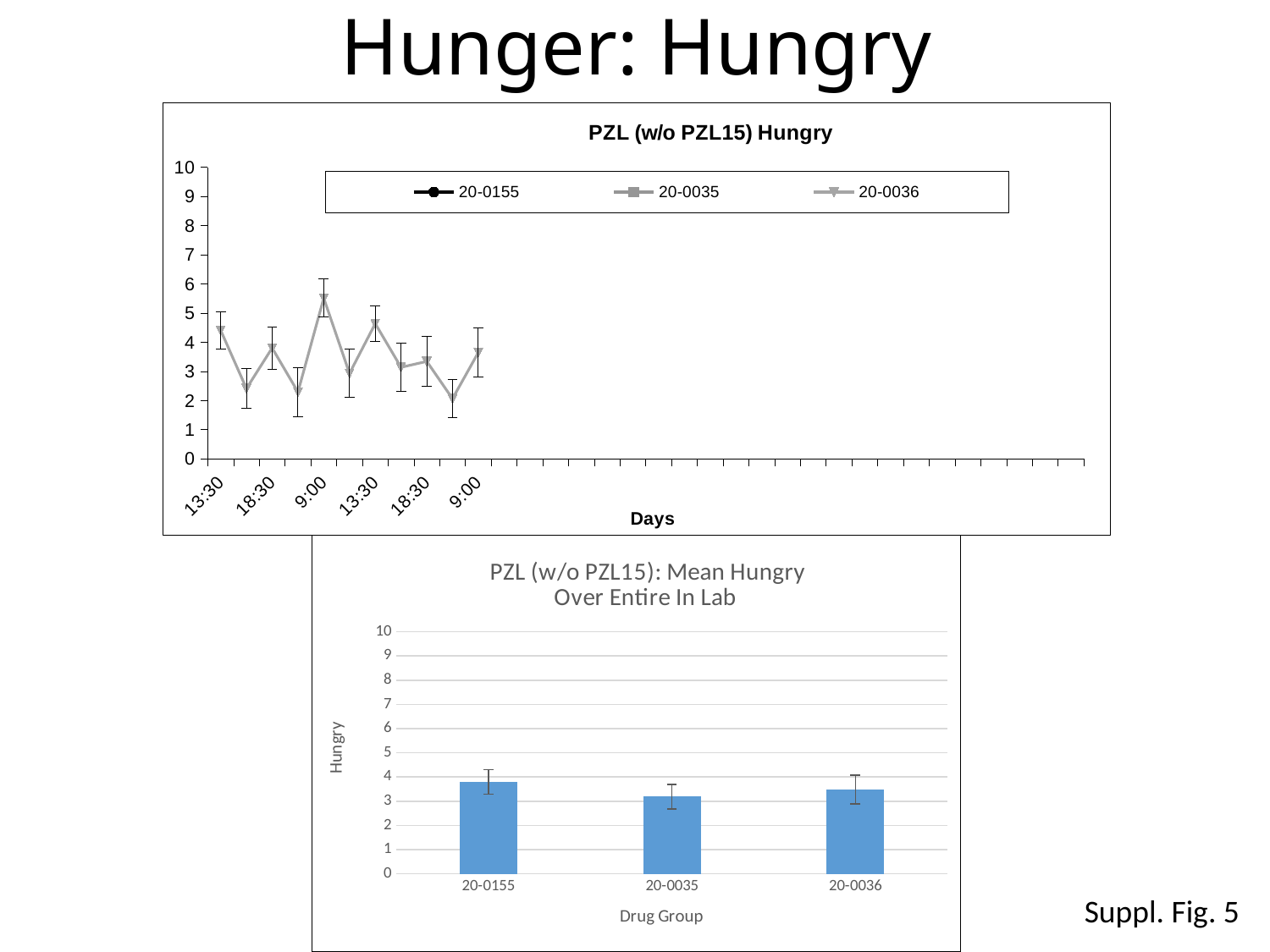
What kind of chart is the bottom chart titled 'PZL (w/o PZL15): Mean Hungry Over Entire In Lab'? bar chart In the bottom bar chart, which drug group has the lowest mean Hungry value? 20-0035 In the bottom bar chart, which is larger, the value for 20-0155 or the value for 20-0035? 20-0155 In the bottom bar chart, is the value for 20-0035 greater or less than 4? less What is the x-axis title of the top line chart? Days In the top chart, how many series does the legend list? 3 In the bottom bar chart, is the value for 20-0155 greater or less than 3? greater In the bottom bar chart, which drug group has the highest mean Hungry value? 20-0155 In the bottom bar chart, how many drug groups are shown on the x axis? 3 What is the x-axis title of the bottom bar chart? Drug Group In the top chart, is the highest plotted point greater or less than 5? greater What kind of chart is the top chart titled 'PZL (w/o PZL15) Hungry'? line chart